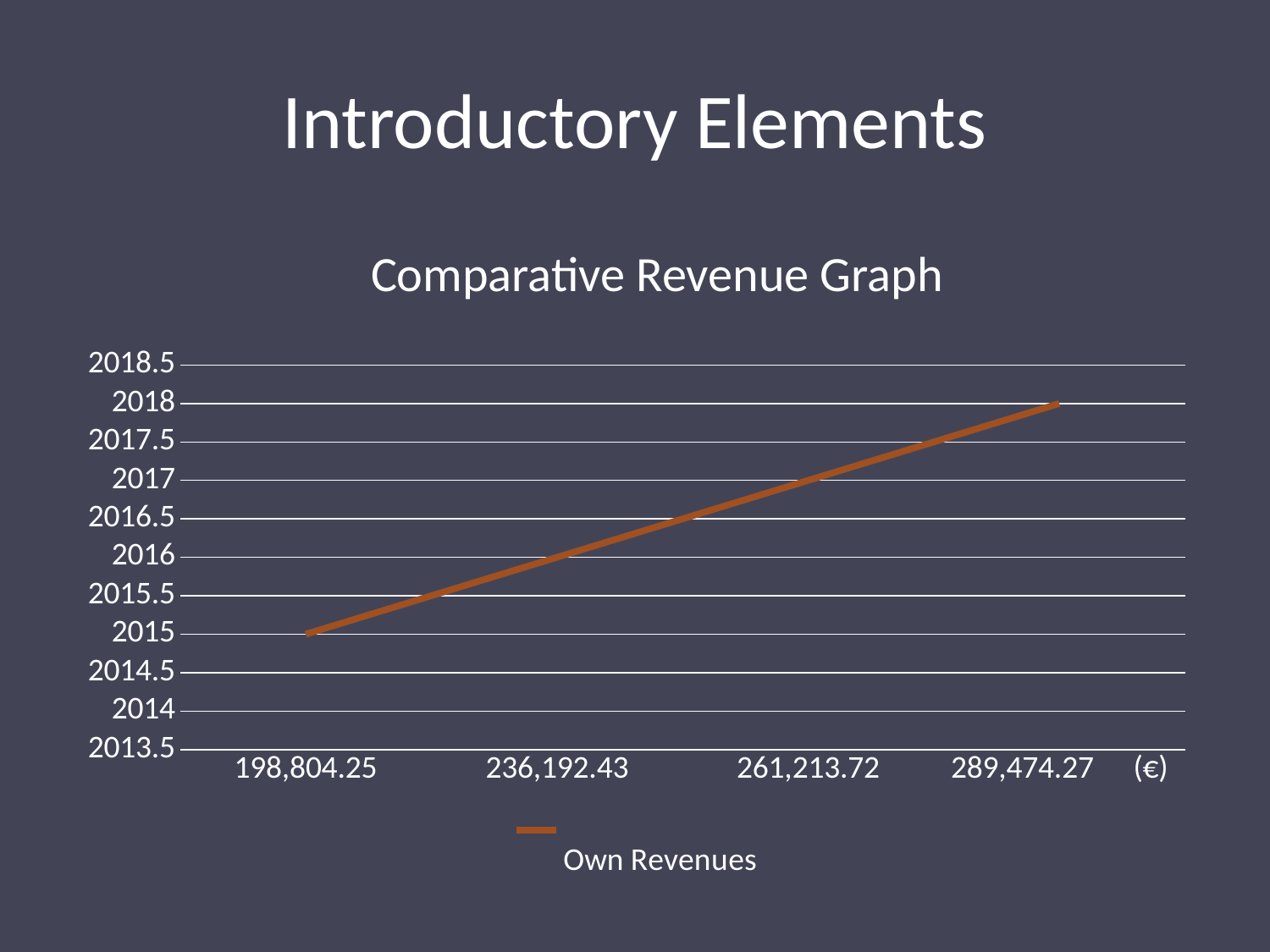
What is the title of the chart? Comparative Revenue Graph What is the value for the category 198,804.25? 2015 What is the name of the series shown in the legend? Own Revenues What is the value for the category 289,474.27? 2018 How many series does the legend list? 1 Which category has the highest value? 289,474.27 Which is larger, the value for 261,213.72 or the value for 198,804.25? 261,213.72 What kind of chart is shown on the slide? line chart Is the value for 236,192.43 greater or less than 2015.5? greater Which category has the lowest value? 198,804.25 How many categories are shown on the x axis? 4 Do the values rise or fall along the x axis? rise